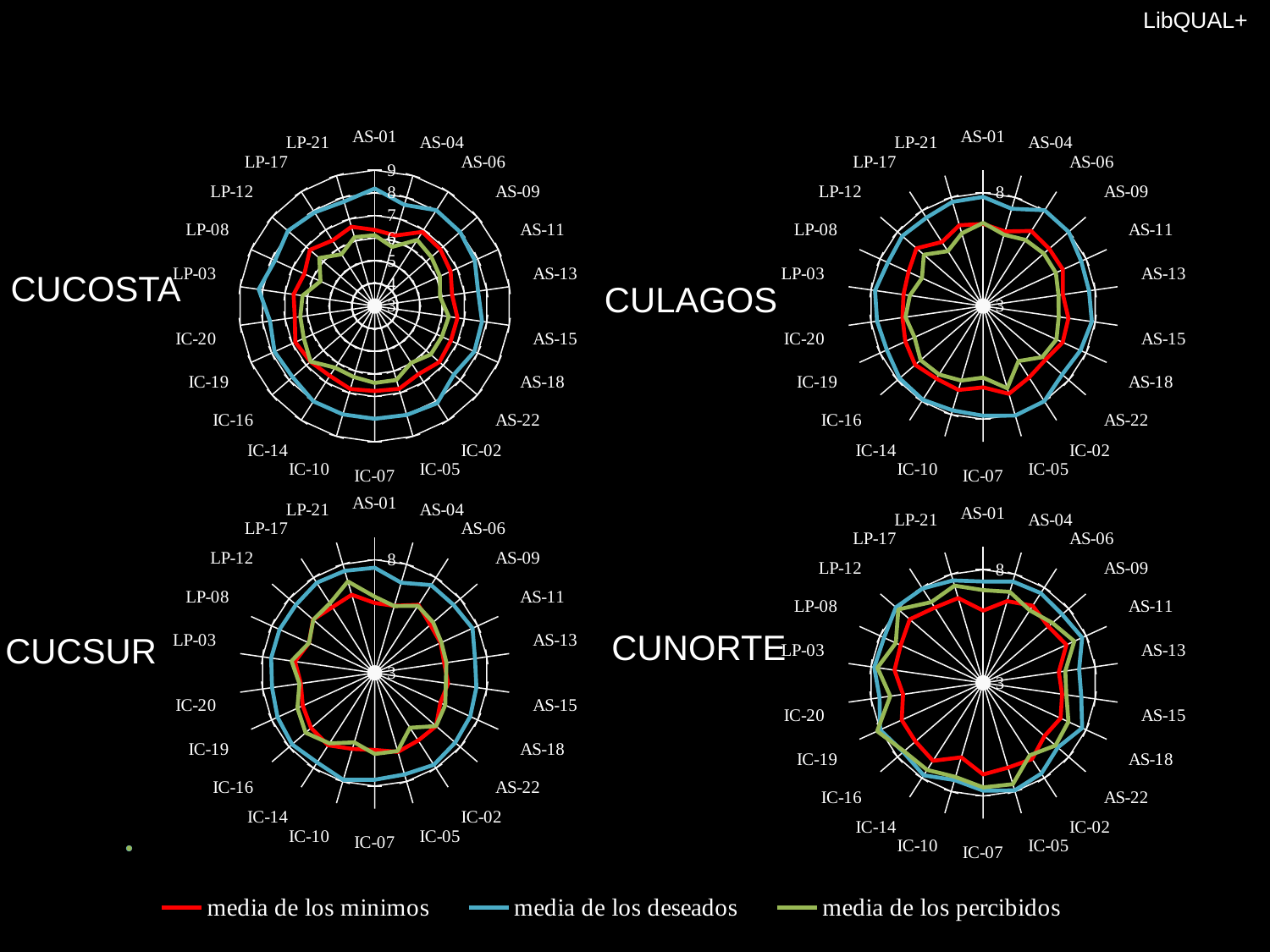
On the CULAGOS chart, which is larger at IC-07: media de los deseados or media de los minimos? media de los deseados On the CUCOSTA chart, is the value of media de los minimos at AS-01 greater or less than 9? less Which series is drawn in red in the legend? media de los minimos Which series is drawn in blue in the legend? media de los deseados How many radar charts are shown on the slide? 4 On the CUCOSTA chart, which is larger at AS-01: media de los deseados or media de los minimos? media de los deseados What kind of chart is the CUCOSTA chart? radar chart How many series does the legend list? 3 On the CUNORTE chart, which is larger at AS-13: media de los percibidos or media de los minimos? media de los percibidos On the CUCSUR chart, is the value of media de los deseados at AS-01 greater or less than 3? greater How many categories are plotted on the CULAGOS chart? 22 On the CUNORTE chart, is the value of media de los minimos at IC-07 greater or less than 8? less